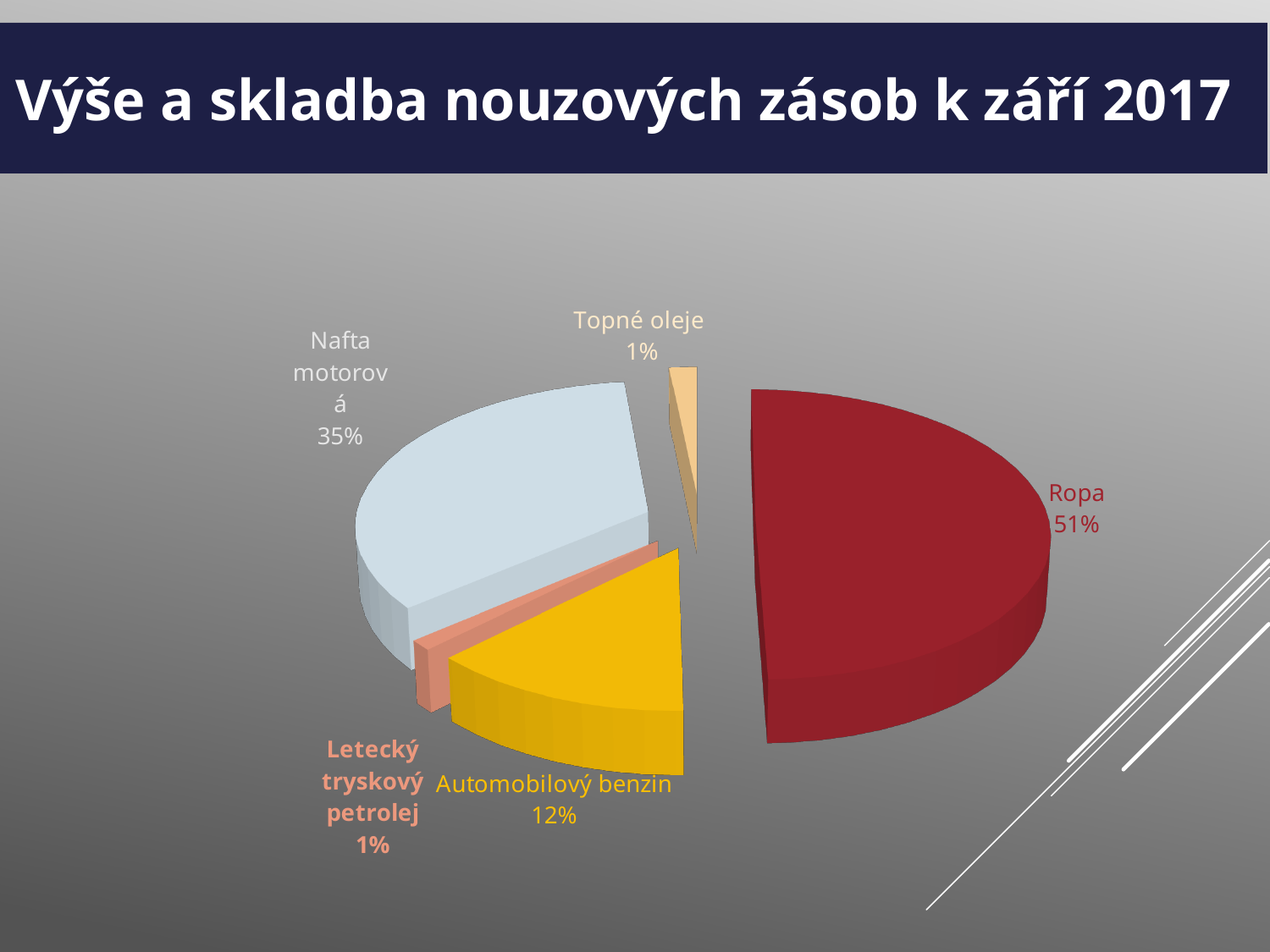
What share of the pie does Topné oleje represent? 1% What kind of chart is shown on the slide? pie chart What share of the pie does Letecký tryskový petrolej represent? 1% What share of the pie does Nafta motorová represent? 35% What share of the pie does Automobilový benzin represent? 12% What is the title of the slide containing the pie chart? Výše a skladba nouzových zásob k září 2017 What is the difference in percentage points between Ropa and Nafta motorová? 16 Which category has the largest slice of the pie? Ropa How many slices does the pie chart have? 5 What share of the pie does Ropa represent? 51% What is the difference in percentage points between Automobilový benzin and Topné oleje? 11 Which is larger, the share for Nafta motorová or the share for Automobilový benzin? Nafta motorová